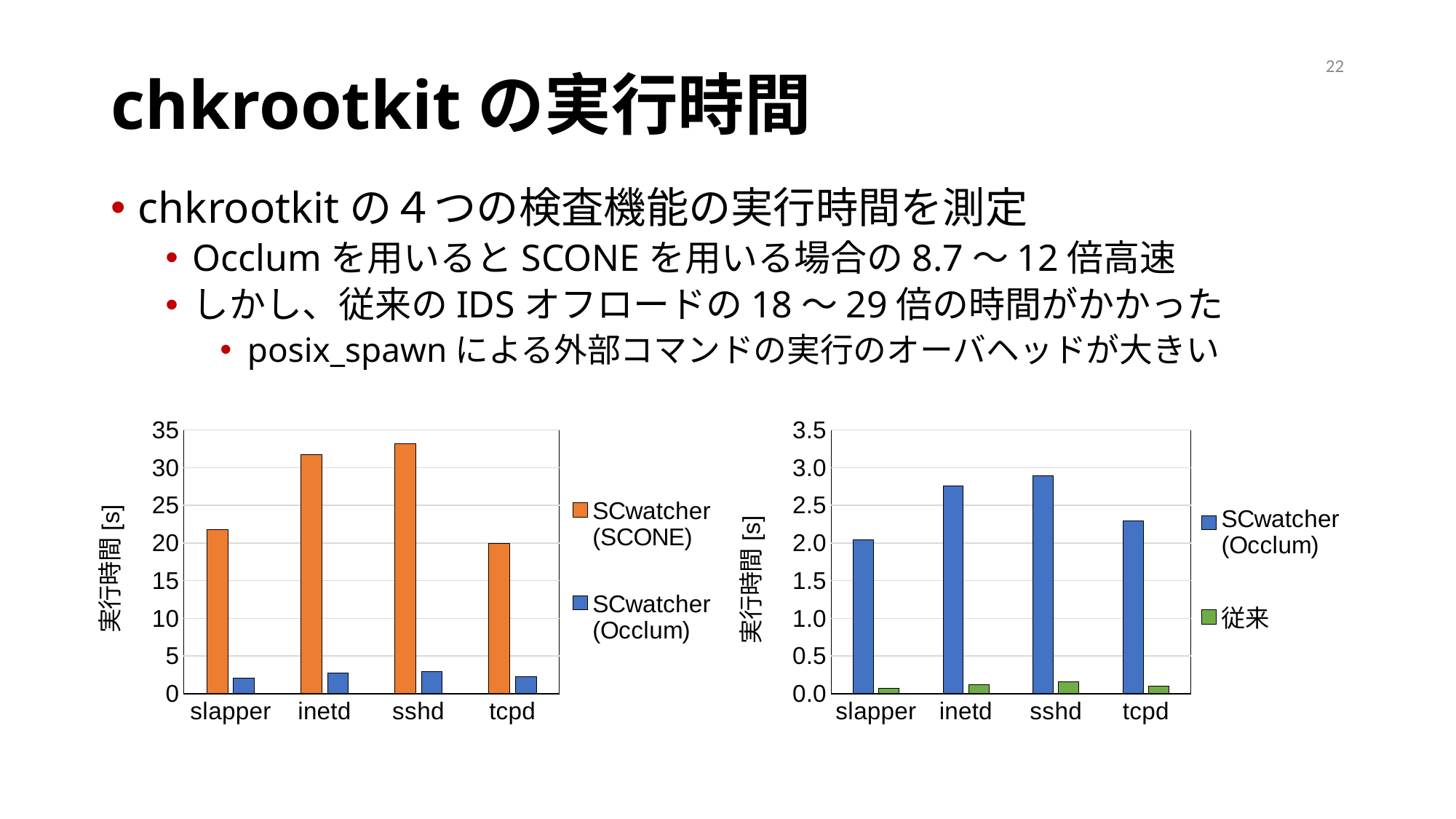
In the left chart, is the SCwatcher (Occlum) value for sshd greater or less than 5? less How many categories are shown on the x axis of the right chart? 4 In the left chart, which category has the highest SCwatcher (SCONE) value? sshd In the right chart, which category has the lowest SCwatcher (Occlum) value? slapper In the right chart, which category has the highest SCwatcher (Occlum) value? sshd What kind of chart is the left chart on the slide? bar chart In the left chart, which is larger for slapper: SCwatcher (SCONE) or SCwatcher (Occlum)? SCwatcher (SCONE) What is the y-axis title of the right chart? 実行時間 [s] In the left chart, which category has the lowest SCwatcher (SCONE) value? tcpd In the left chart, is the SCwatcher (SCONE) value for inetd greater or less than 30? greater In the right chart, is the SCwatcher (Occlum) value for inetd greater or less than 2.5? greater How many series does the legend of the left chart list? 2